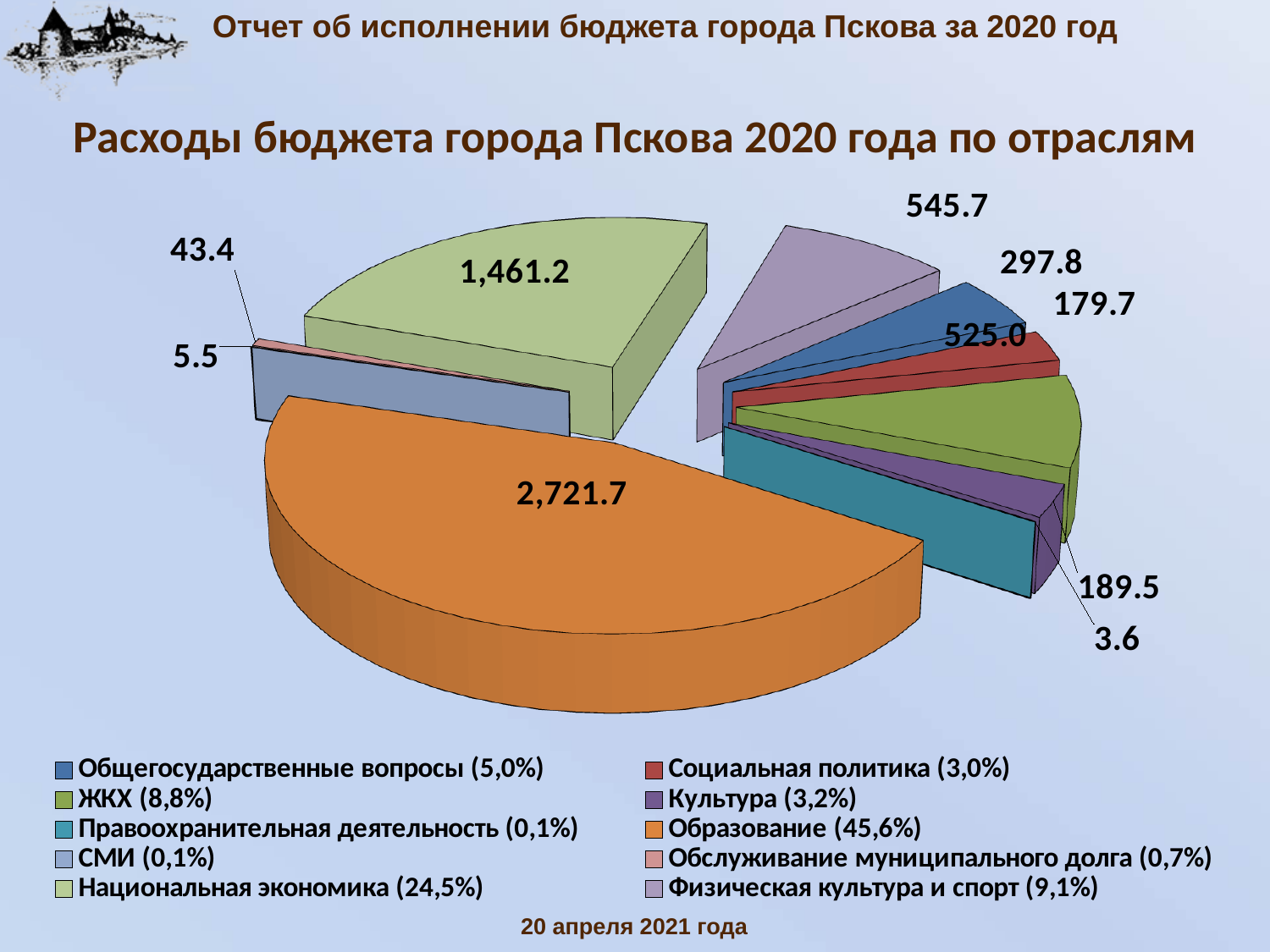
How many categories does the legend list? 10 What is the value shown for ЖКХ? 525.0 Which category has the largest slice of the pie? Образование What is the difference between the values for Образование and Национальная экономика? 1,260.5 What is the value shown for Национальная экономика? 1,461.2 Which category has the smallest value in the chart? Правоохранительная деятельность What share of the pie does Физическая культура и спорт account for, according to the legend? 9,1% What is the value shown for Образование? 2,721.7 What is the value shown for Физическая культура и спорт? 545.7 What share of the pie does Национальная экономика account for, according to the legend? 24,5% What kind of chart is shown on the slide? pie chart Which is larger, the value for Общегосударственные вопросы or the value for Социальная политика? Общегосударственные вопросы